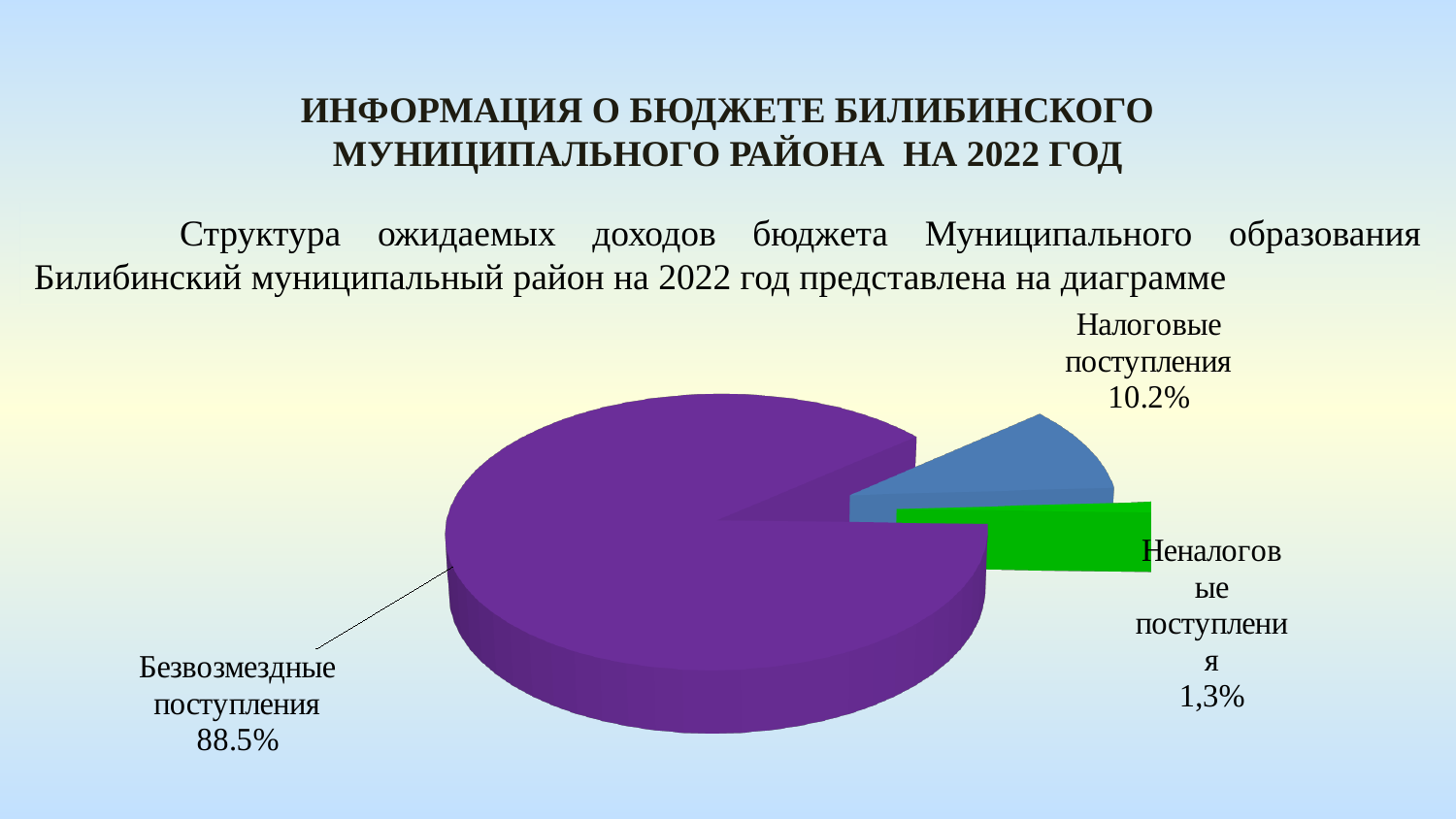
What share of the pie does Безвозмездные поступления represent? 88.5% Which category has the largest slice of the pie? Безвозмездные поступления What colour is the slice for Безвозмездные поступления? Purple What kind of chart is shown on the slide? Pie chart Which category has the smallest slice of the pie? Неналоговые поступления What colour is the slice for Неналоговые поступления? Green What is the difference between the shares of Налоговые поступления and Неналоговые поступления? 8.9% How many categories are shown in the pie chart? 3 What is the value shown for Неналоговые поступления? 1,3% What is the difference between the shares of Безвозмездные поступления and Налоговые поступления? 78.3% Which is larger: Налоговые поступления or Неналоговые поступления? Налоговые поступления What is the value shown for Налоговые поступления? 10.2%